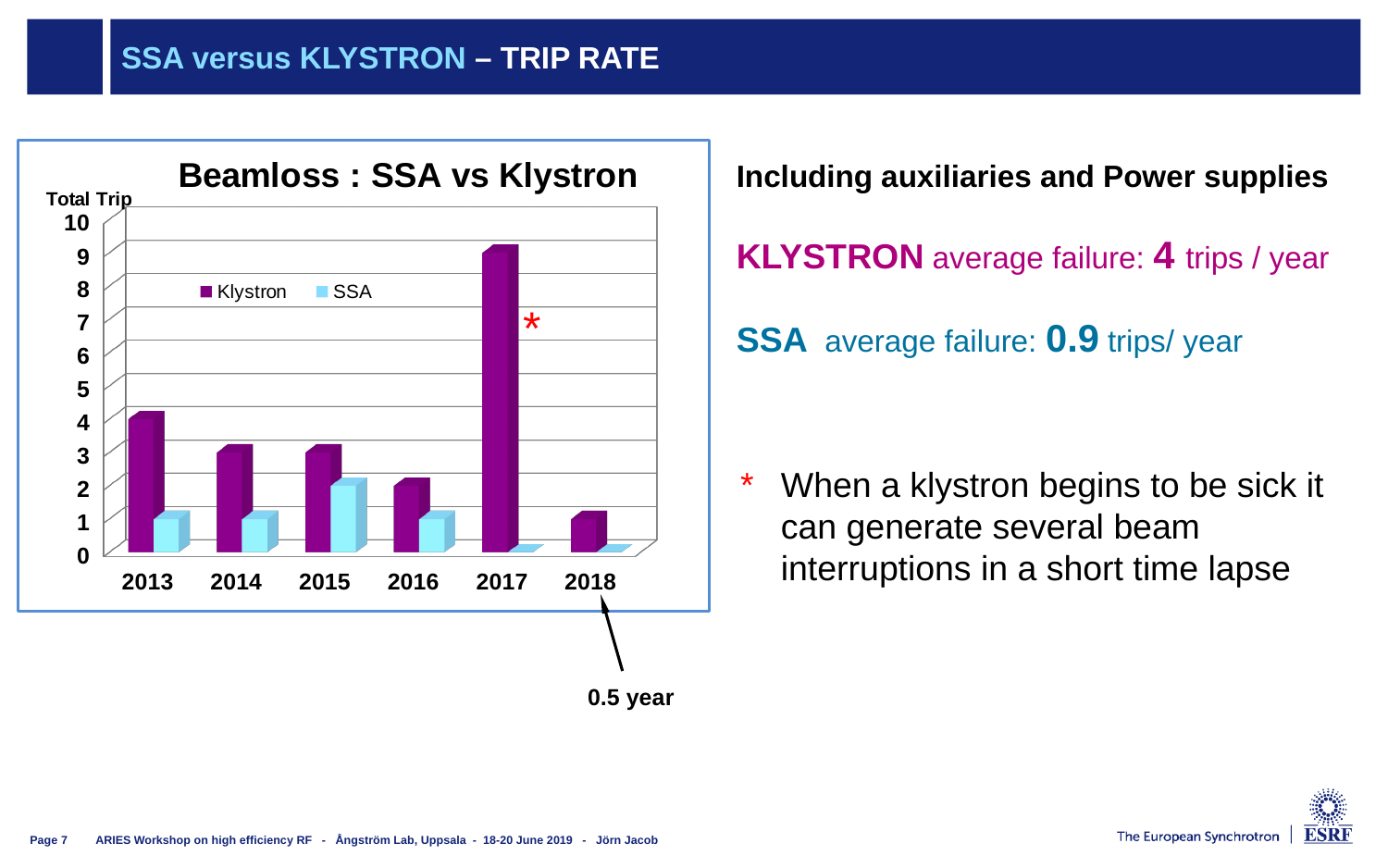
What is the Klystron value for 2017? 9 How many series does the chart legend list? 2 Which series has the larger value in 2016, Klystron or SSA? Klystron Is the Klystron value for 2017 greater or less than 5? greater What type of chart is shown on the slide? bar chart What is the Klystron value for 2013? 4 What is the difference between the Klystron and SSA values in 2017? 9 What is the title of the chart? Beamloss : SSA vs Klystron What is the SSA value for 2015? 2 In which year is the Klystron value highest? 2017 In which year is the Klystron value lowest? 2018 How many years are shown on the x axis of the chart? 6